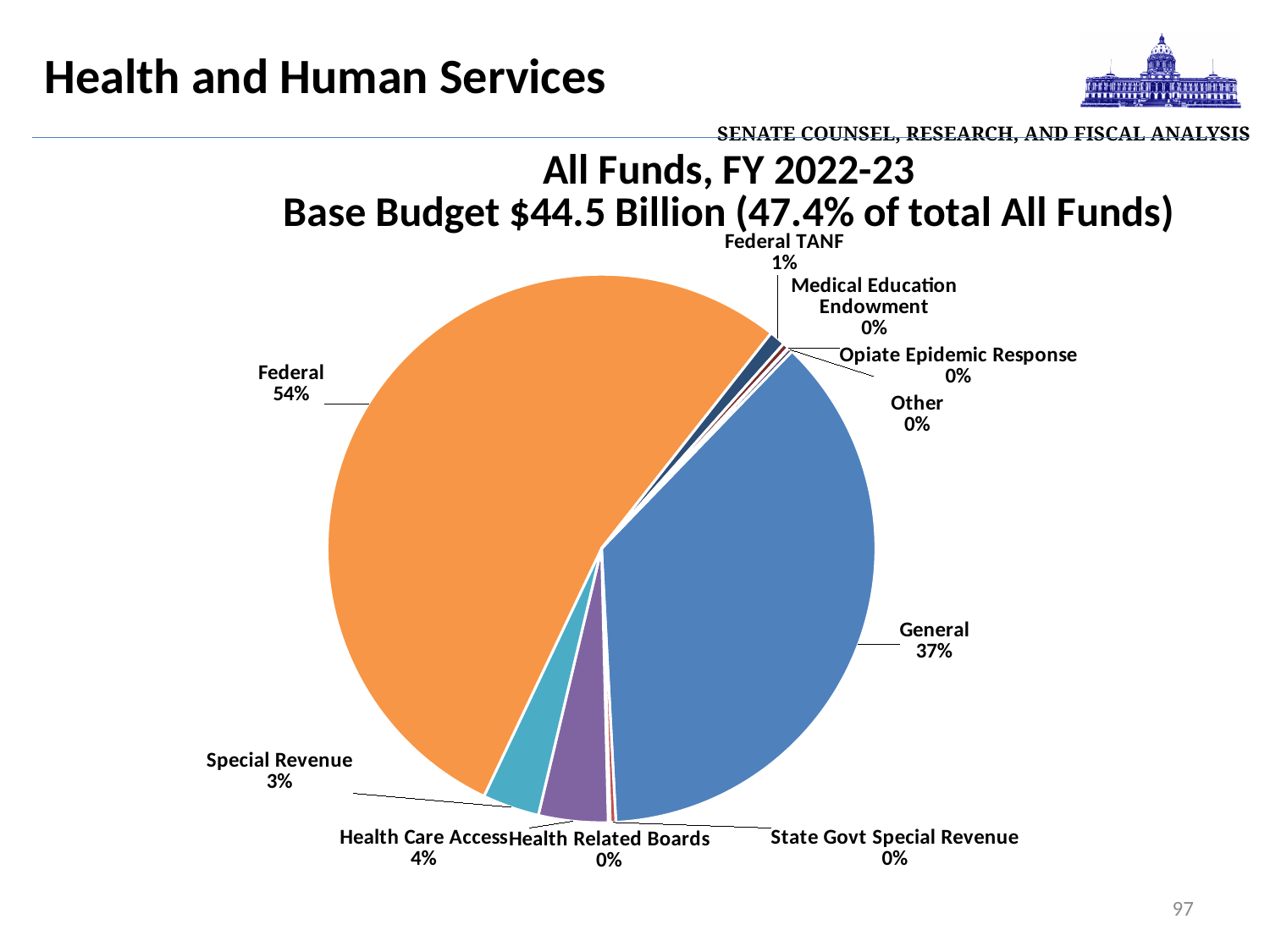
What type of chart is shown on the slide? Pie chart What percentage is shown for Special Revenue? 3% What is the difference in percentage points between Federal and General? 17% What share of the pie does Federal represent? 54% Which is larger, Health Care Access or Special Revenue? Health Care Access According to the chart title, what percentage of total All Funds does this base budget represent? 47.4% What share of the pie does General represent? 37% How many categories are labelled on the pie chart? 10 What base budget amount is stated in the chart title? $44.5 Billion What percentage is shown for Health Care Access? 4% Which category has the largest slice of the pie? Federal What percentage is shown for Federal TANF? 1%